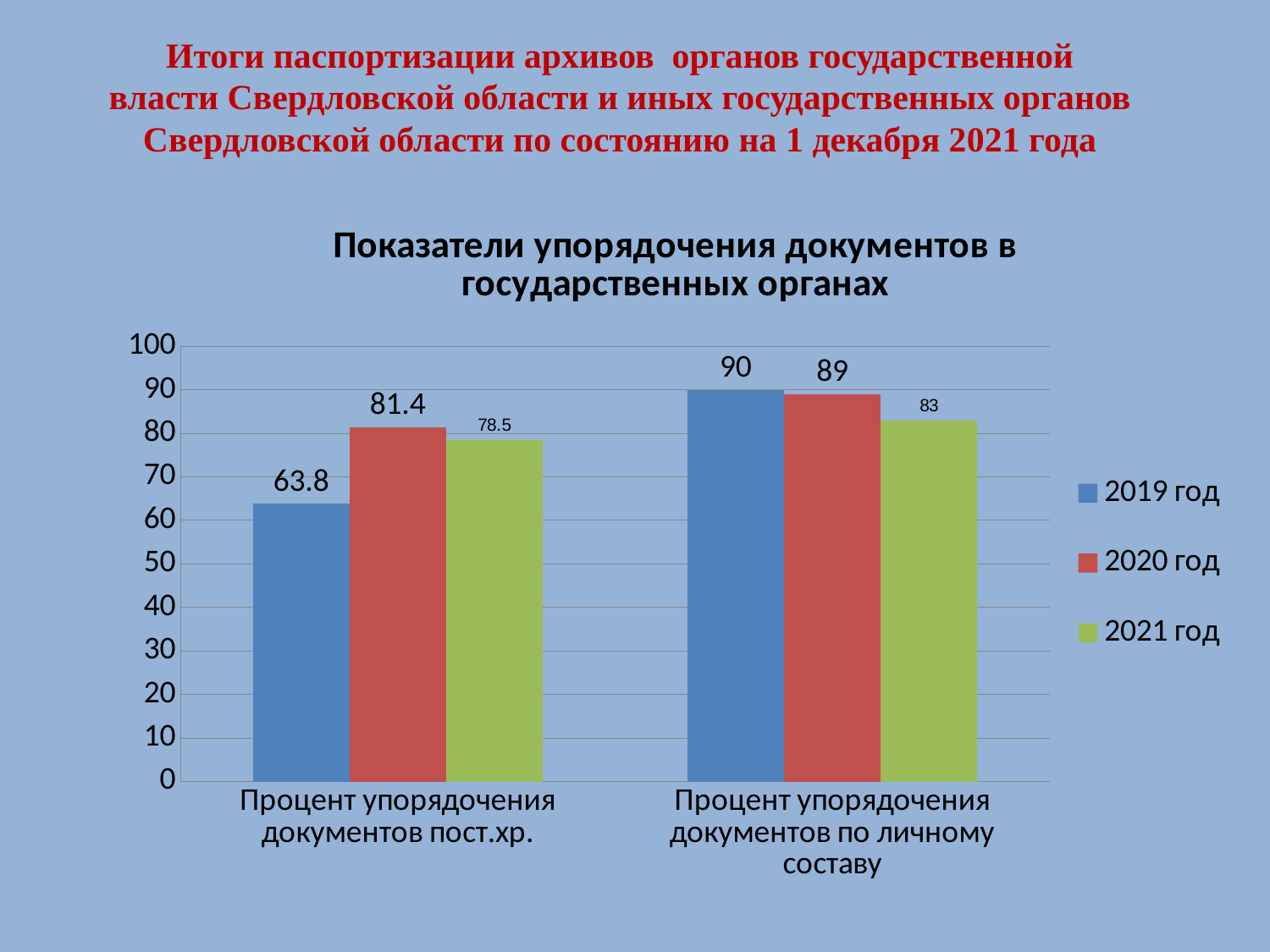
What is the value for 2019 год for 'Процент упорядочения документов пост.хр.'? 63.8 Which is larger: the 2021 год value for 'Процент упорядочения документов пост.хр.' or the 2021 год value for 'Процент упорядочения документов по личному составу'? Процент упорядочения документов по личному составу Which year has the lowest value for 'Процент упорядочения документов пост.хр.'? 2019 год What is the value for 2020 год for 'Процент упорядочения документов пост.хр.'? 81.4 What is the value for 2019 год for 'Процент упорядочения документов по личному составу'? 90 What kind of chart is shown on the slide? Bar chart What is the difference between the 2020 год and 2019 год values for 'Процент упорядочения документов пост.хр.'? 17.6 How many series does the legend list? 3 What is the difference between the 2019 год and 2021 год values for 'Процент упорядочения документов по личному составу'? 7 What is the title of the chart? Показатели упорядочения документов в государственных органах Which year has the highest value for 'Процент упорядочения документов по личному составу'? 2019 год What is the value for 2021 год for 'Процент упорядочения документов по личному составу'? 83